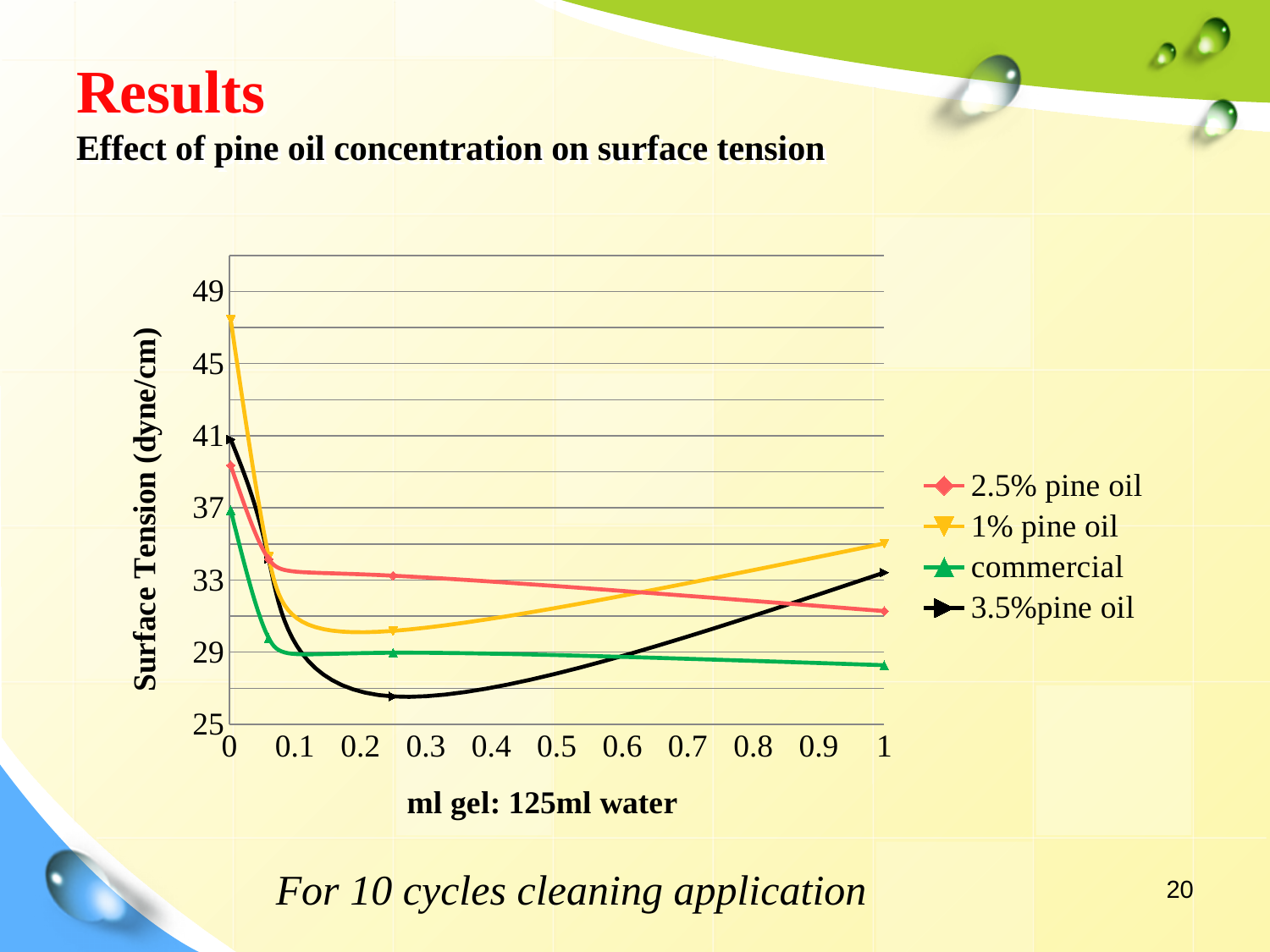
Which series has the highest surface tension at 1 ml gel? 1% pine oil Which series has the lowest surface tension at 1 ml gel? commercial Is the surface tension for 2.5% pine oil at 1 ml gel greater or less than 29? greater Which series has the lowest surface tension at 0 ml gel? commercial Which series has the highest surface tension at 0 ml gel? 1% pine oil Does the surface tension for 2.5% pine oil rise or fall as the gel amount increases from 0 to 1? fall What kind of chart is shown on the slide? line chart At 1 ml gel, which series has the higher surface tension: 3.5% pine oil or 2.5% pine oil? 3.5% pine oil Is the surface tension for 3.5% pine oil at about 0.25 ml gel greater or less than 29? less Is the surface tension for 1% pine oil at 0 ml gel greater or less than 45? greater How many series does the legend list? 4 What is the title of the y axis? Surface Tension (dyne/cm)